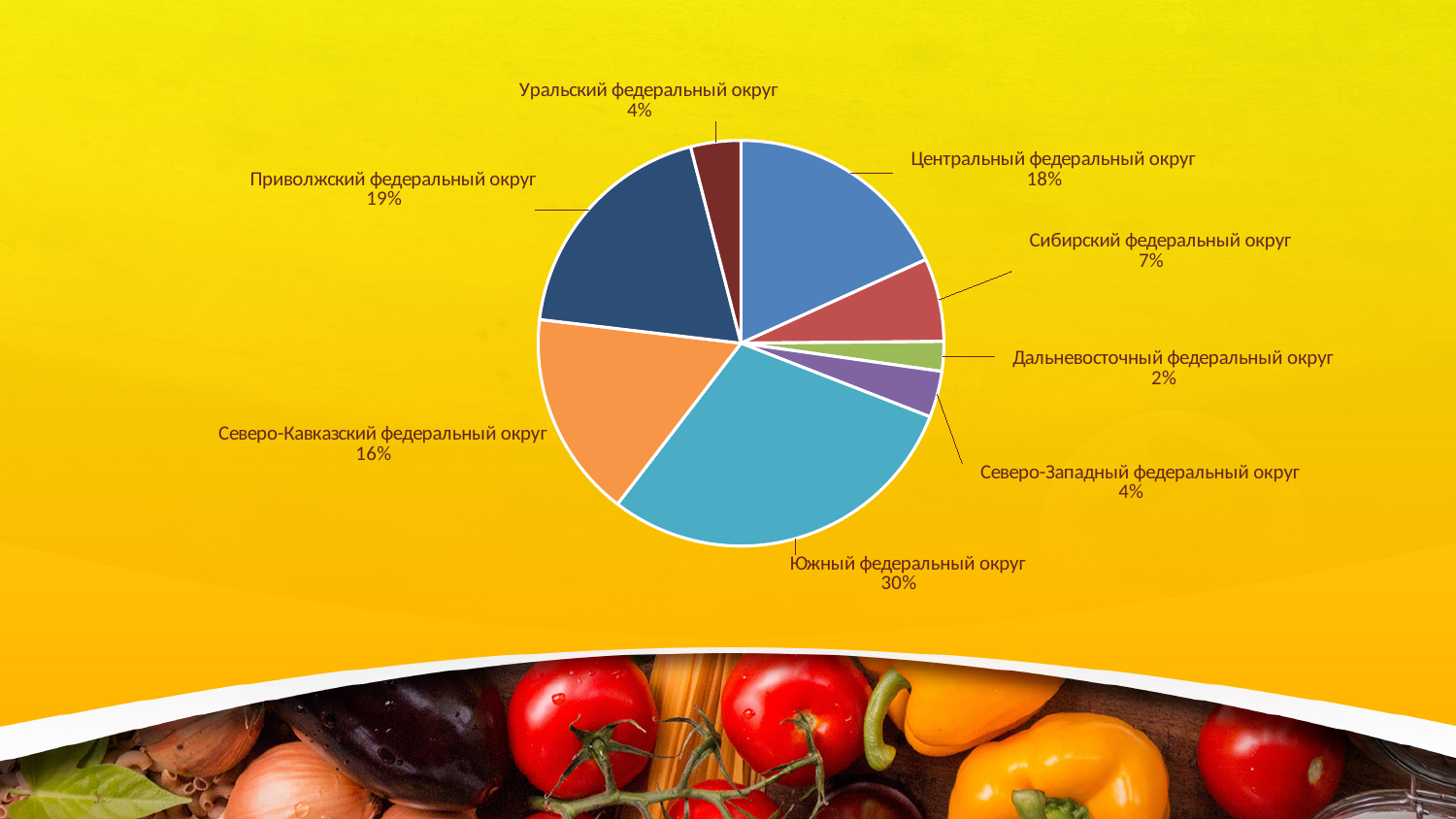
What share of the pie does Южный федеральный округ have? 30% What is the value shown for Дальневосточный федеральный округ? 2% Which federal district has the smallest slice of the pie? Дальневосточный федеральный округ What is the difference between the shares of Южный федеральный округ and Северо-Кавказский федеральный округ? 14% What kind of chart is shown on the slide? pie chart What colour is the slice for Южный федеральный округ? teal (light blue) How many slices does the pie chart have? 8 Which federal district has the largest slice of the pie? Южный федеральный округ Which is larger, the share of Сибирский федеральный округ or the share of Северо-Западный федеральный округ? Сибирский федеральный округ What is the combined share of Уральский федеральный округ and Северо-Западный федеральный округ? 8% What is the value shown for Центральный федеральный округ? 18% What is the value shown for Приволжский федеральный округ? 19%